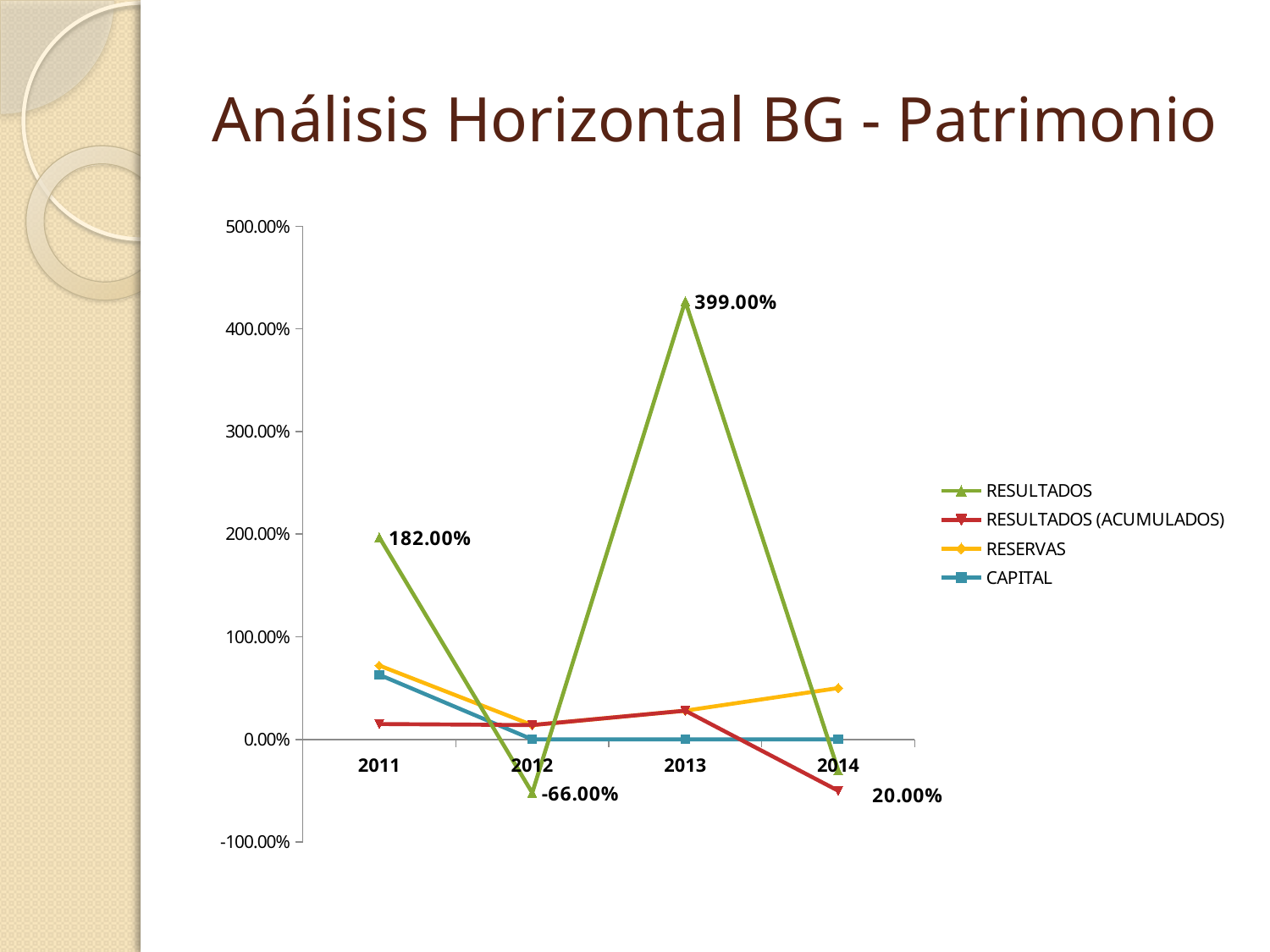
How many series does the legend list? 4 What is the difference between the RESULTADOS values for 2013 and 2011? 217.00% What is the value for RESULTADOS in 2012? -66.00% What is the value for RESULTADOS in 2011? 182.00% In which year is the RESULTADOS series at its highest? 2013 What is the title of the slide? Análisis Horizontal BG - Patrimonio In which year is the RESULTADOS series at its lowest? 2012 How many years are shown on the x axis? 4 Which is larger for RESULTADOS: the 2011 value or the 2013 value? 2013 What kind of chart is shown on the slide? line chart Is the value for RESERVAS in 2011 greater or less than 100.00%? less What is the value for RESULTADOS in 2013? 399.00%